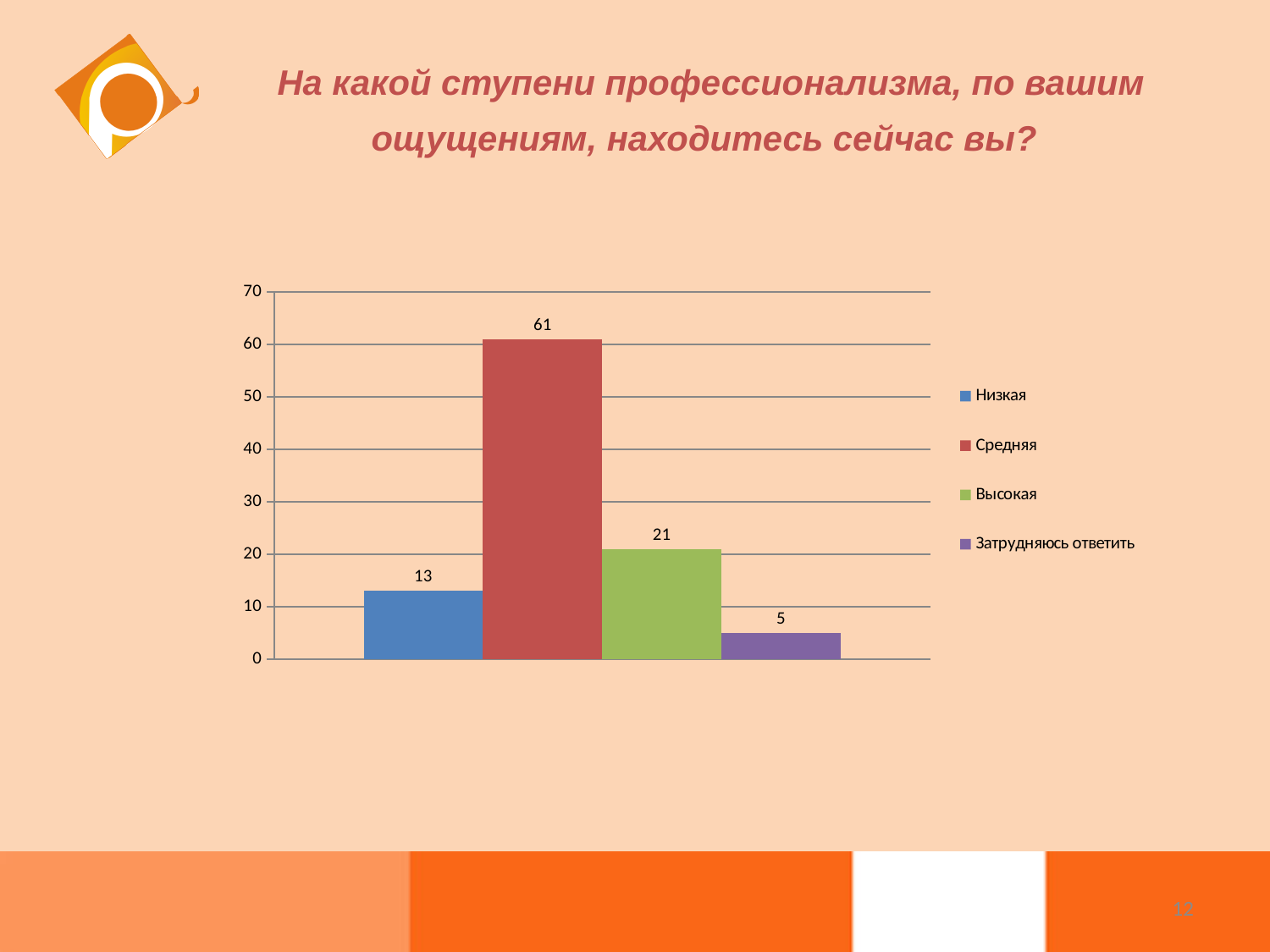
Which category has the lowest value? Затрудняюсь ответить What is the value for Высокая? 21 Which category has the highest value? Средняя What is the value for Средняя? 61 What is the difference between the values for Средняя and Высокая? 40 What is the value for Затрудняюсь ответить? 5 What colour is the bar for Средняя? red Which is larger, the value for Высокая or the value for Низкая? Высокая Is the value for Средняя greater or less than 50? greater What kind of chart is shown on the slide? bar chart How many series does the legend list? 4 What is the value for Низкая? 13